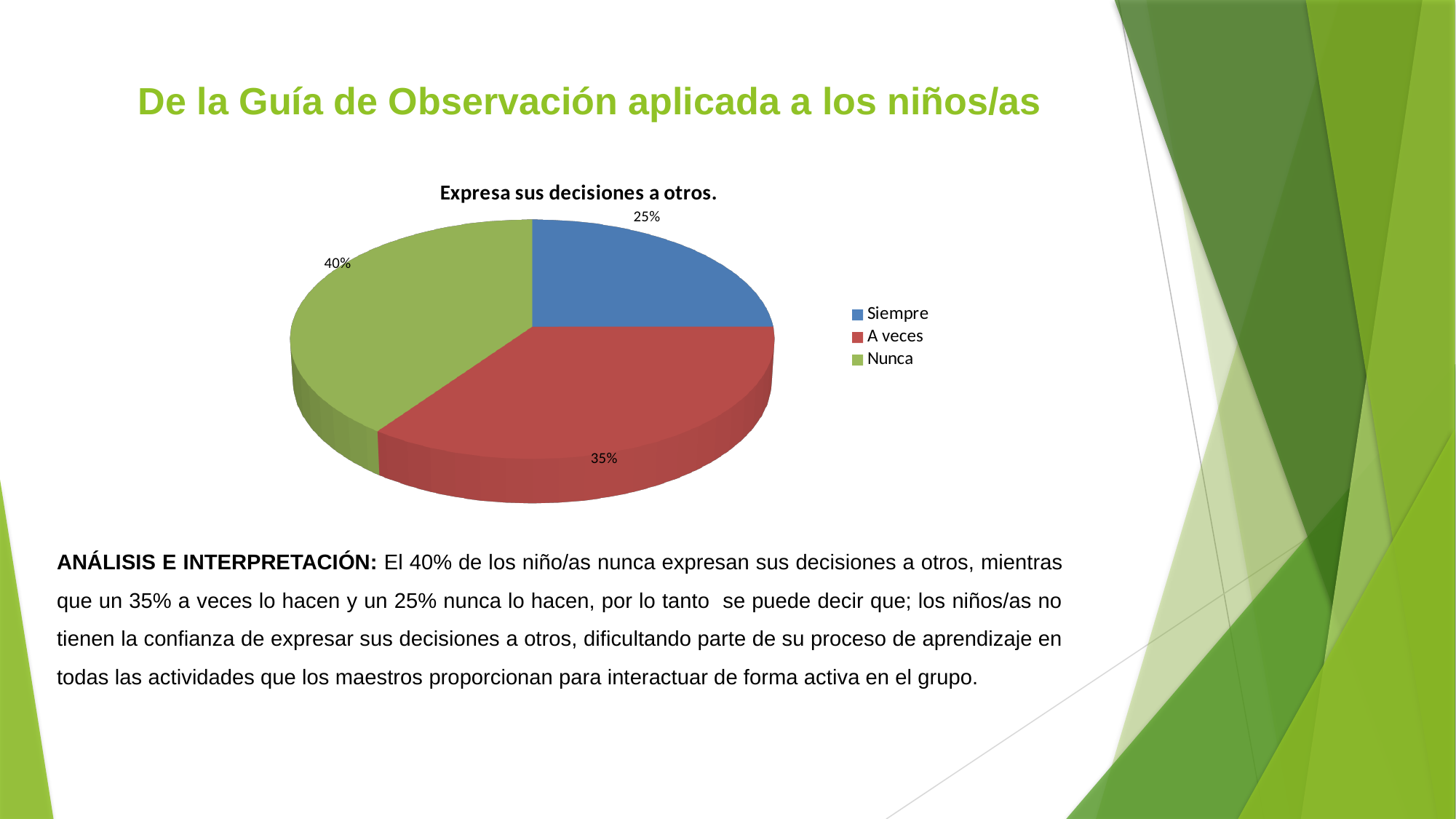
Which category has the largest share of the pie? Nunca What is the difference in percentage points between Nunca and Siempre? 15 How many categories does the legend list? 3 Which category has the smallest share of the pie? Siempre What kind of chart is shown on the slide? pie chart Which is larger, the share for A veces or the share for Siempre? A veces What is the difference in percentage points between A veces and Siempre? 10 What percentage is shown for A veces? 35% What percentage is shown for Siempre? 25% What colour represents Nunca in the pie chart? green What percentage is shown for Nunca? 40% What is the title of the chart? Expresa sus decisiones a otros.